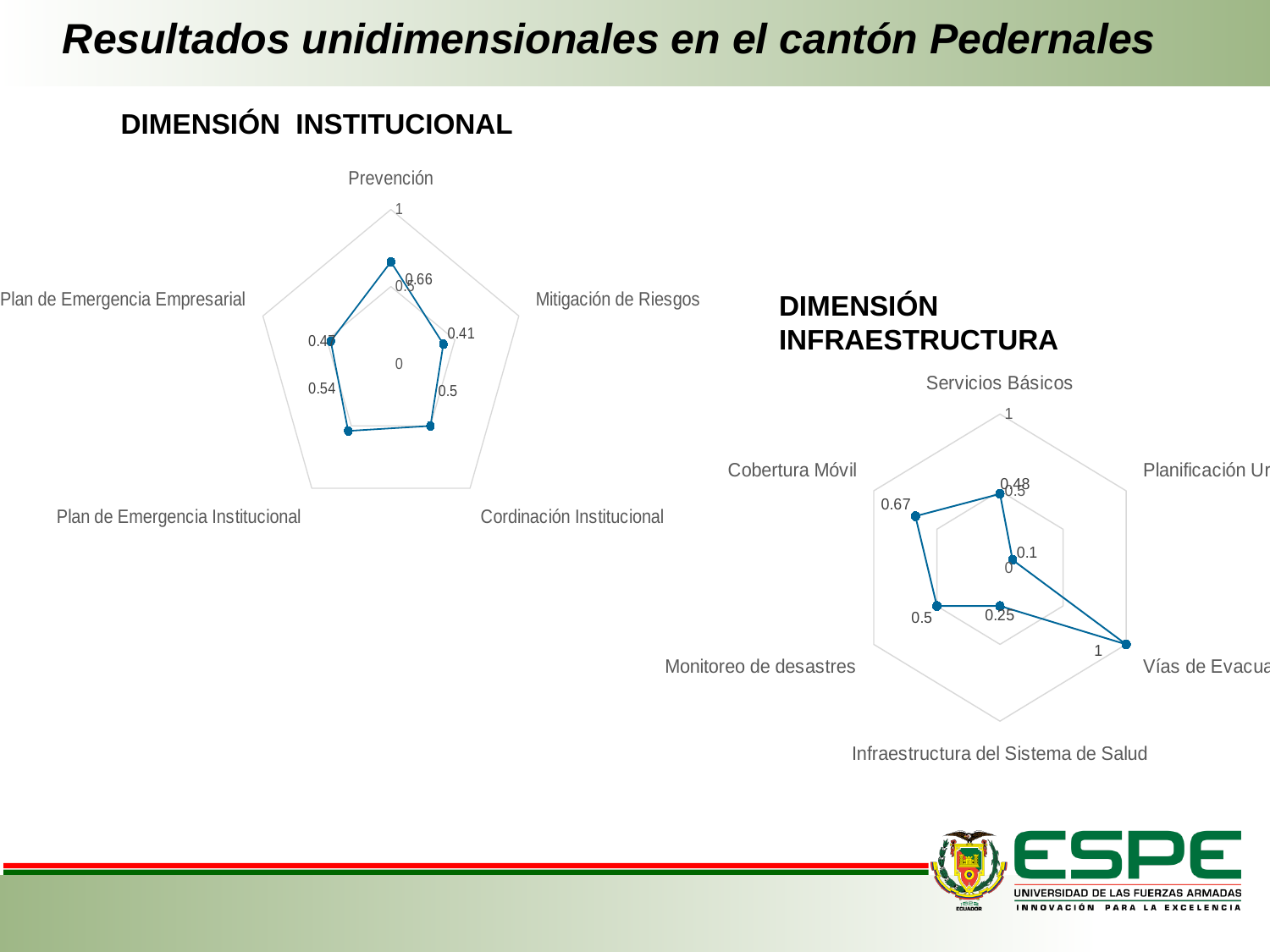
In the DIMENSIÓN INSTITUCIONAL chart, what is the value for Plan de Emergencia Institucional? 0.54 In the DIMENSIÓN INFRAESTRUCTURA chart, what is the value for Cobertura Móvil? 0.67 In the DIMENSIÓN INSTITUCIONAL chart, how many categories are plotted? 5 In the DIMENSIÓN INFRAESTRUCTURA chart, what is the value for Servicios Básicos? 0.48 In the DIMENSIÓN INSTITUCIONAL chart, which category has the highest value? Prevención In the DIMENSIÓN INSTITUCIONAL chart, what is the value for Mitigación de Riesgos? 0.41 In the DIMENSIÓN INSTITUCIONAL chart, what is the difference between the values for Prevención and Mitigación de Riesgos? 0.25 In the DIMENSIÓN INSTITUCIONAL chart, what is the value for Prevención? 0.66 In the DIMENSIÓN INFRAESTRUCTURA chart, how many categories are plotted? 6 What kind of chart is the DIMENSIÓN INSTITUCIONAL chart? Radar chart In the DIMENSIÓN INFRAESTRUCTURA chart, what is the value for Infraestructura del Sistema de Salud? 0.25 In the DIMENSIÓN INFRAESTRUCTURA chart, which is larger: the value for Cobertura Móvil or the value for Monitoreo de desastres? Cobertura Móvil